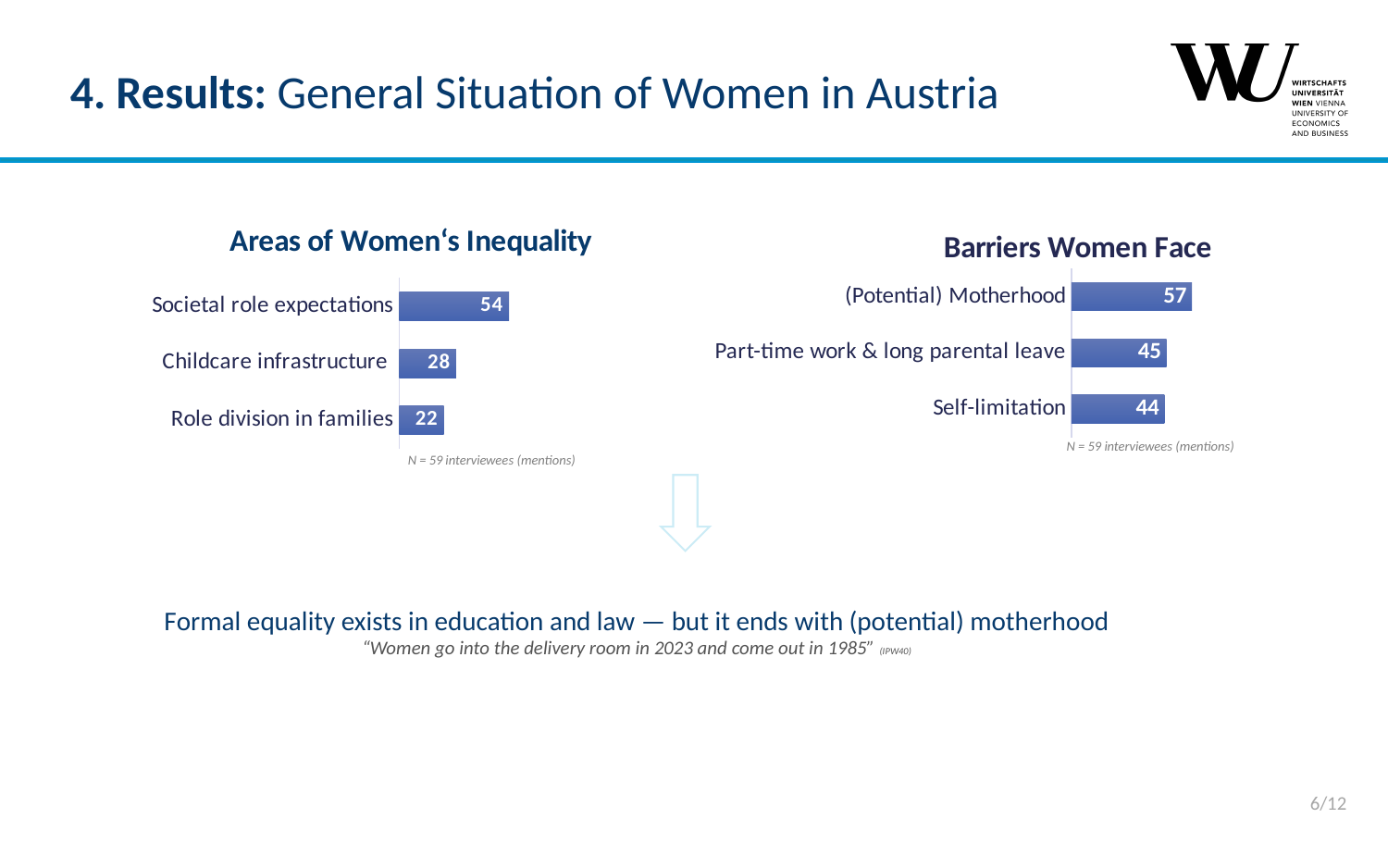
In the 'Barriers Women Face' chart, which category has the highest value? (Potential) Motherhood In the 'Areas of Women's Inequality' chart, what is the difference between Societal role expectations and Role division in families? 32 In the 'Areas of Women's Inequality' chart, which category has the lowest value? Role division in families In the 'Barriers Women Face' chart, what is the value for (Potential) Motherhood? 57 In the 'Areas of Women's Inequality' chart, what is the value for Societal role expectations? 54 In the 'Areas of Women's Inequality' chart, how many categories are shown? 3 In the 'Barriers Women Face' chart, what is the difference between (Potential) Motherhood and Part-time work & long parental leave? 12 In the 'Barriers Women Face' chart, what is the value for Self-limitation? 44 What type of chart is the 'Barriers Women Face' chart? Bar chart What is the title of the chart on the left side of the slide? Areas of Women's Inequality In the 'Areas of Women's Inequality' chart, what is the value for Childcare infrastructure? 28 In the 'Barriers Women Face' chart, which is larger: Part-time work & long parental leave or Self-limitation? Part-time work & long parental leave